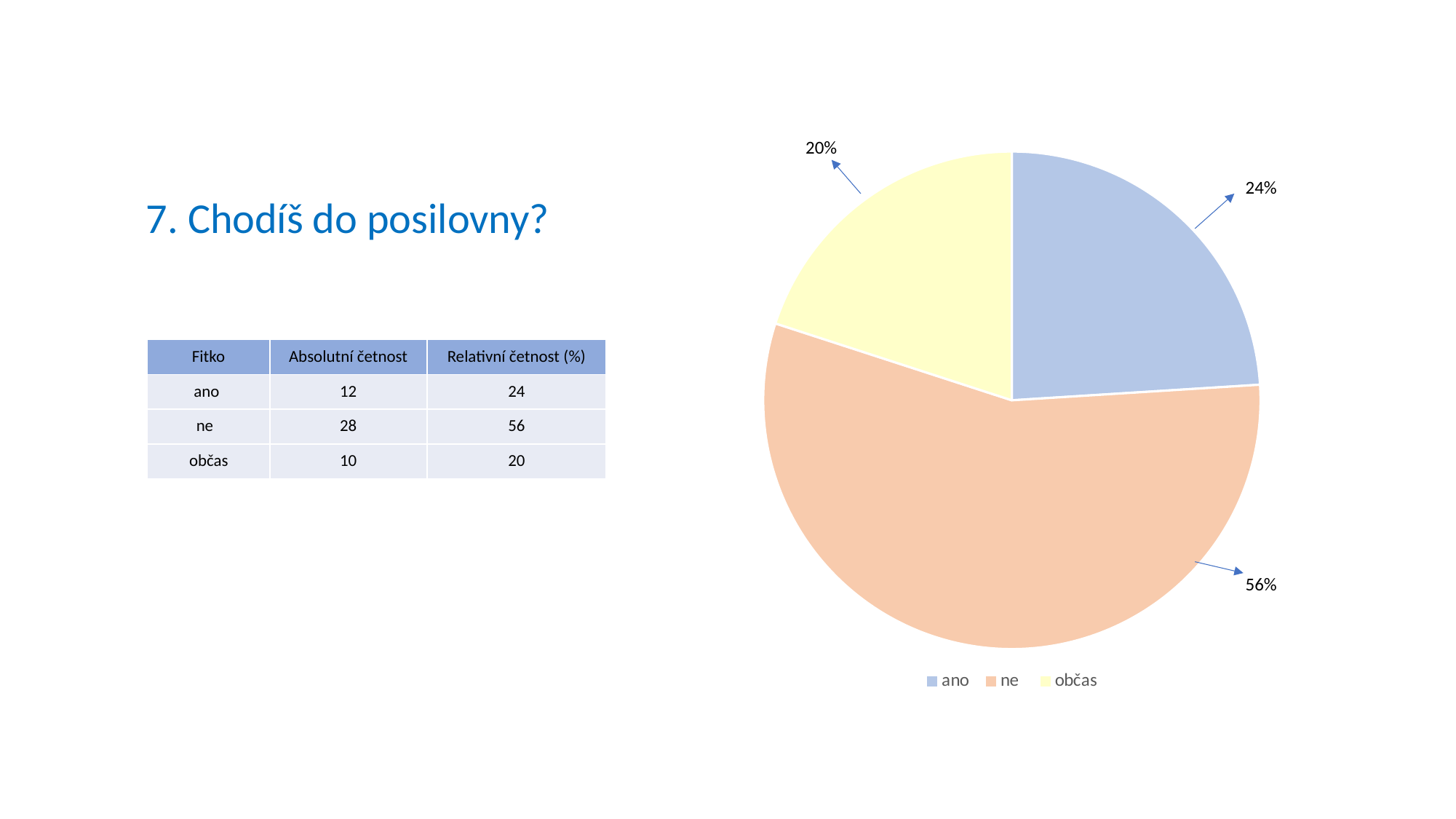
What share of the pie does the "ano" slice represent? 24% How many entries does the legend list? 3 Which slice is larger, "ano" or "občas"? ano Which category has the largest slice of the pie? ne Which category has the smallest slice of the pie? občas Which category is shown in yellow in the pie chart? občas How many slices does the pie chart have? 3 What colour is the "ne" slice in the pie chart? orange What share of the pie does the "ne" slice represent? 56% What share of the pie does the "občas" slice represent? 20% What kind of chart is shown on the slide? pie chart What is the difference in percentage points between the "ne" slice and the "ano" slice? 32